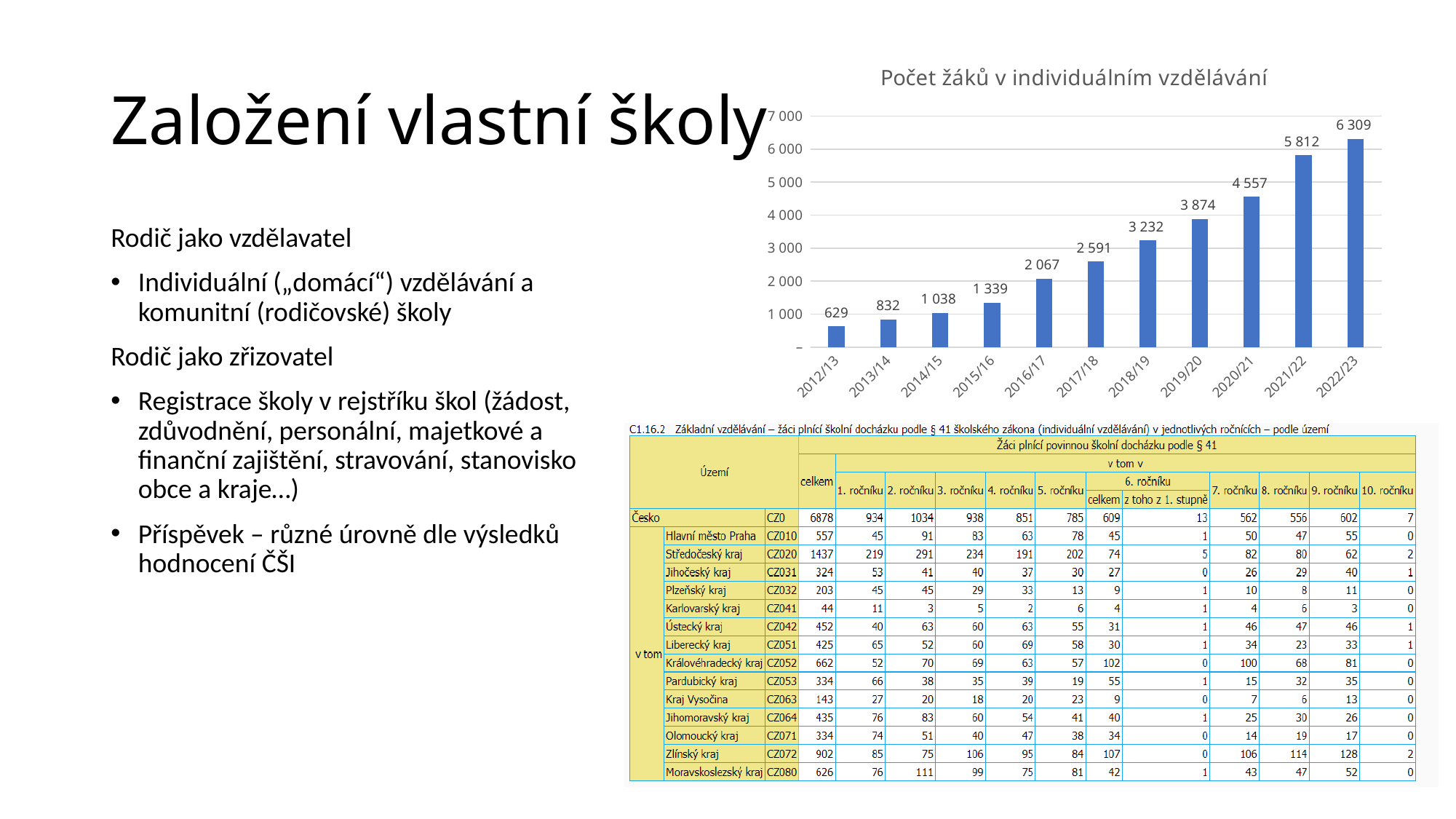
What is the difference between the values for 2022/23 and 2021/22? 497 Which is larger, the value for 2018/19 or the value for 2019/20? 2019/20 What kind of chart is "Počet žáků v individuálním vzdělávání"? bar chart What is the value for 2020/21 in the chart? 4 557 Do the values in the chart rise or fall from 2012/13 to 2022/23? rise Which school year has the highest value in the chart? 2022/23 How many school years are shown on the x axis of the chart? 11 What is the difference between the values for 2016/17 and 2015/16? 728 Which school year has the lowest value in the chart? 2012/13 What is the value for 2017/18 in the chart? 2 591 What is the value for 2012/13 in the chart? 629 What is the value for 2022/23 in the chart "Počet žáků v individuálním vzdělávání"? 6 309